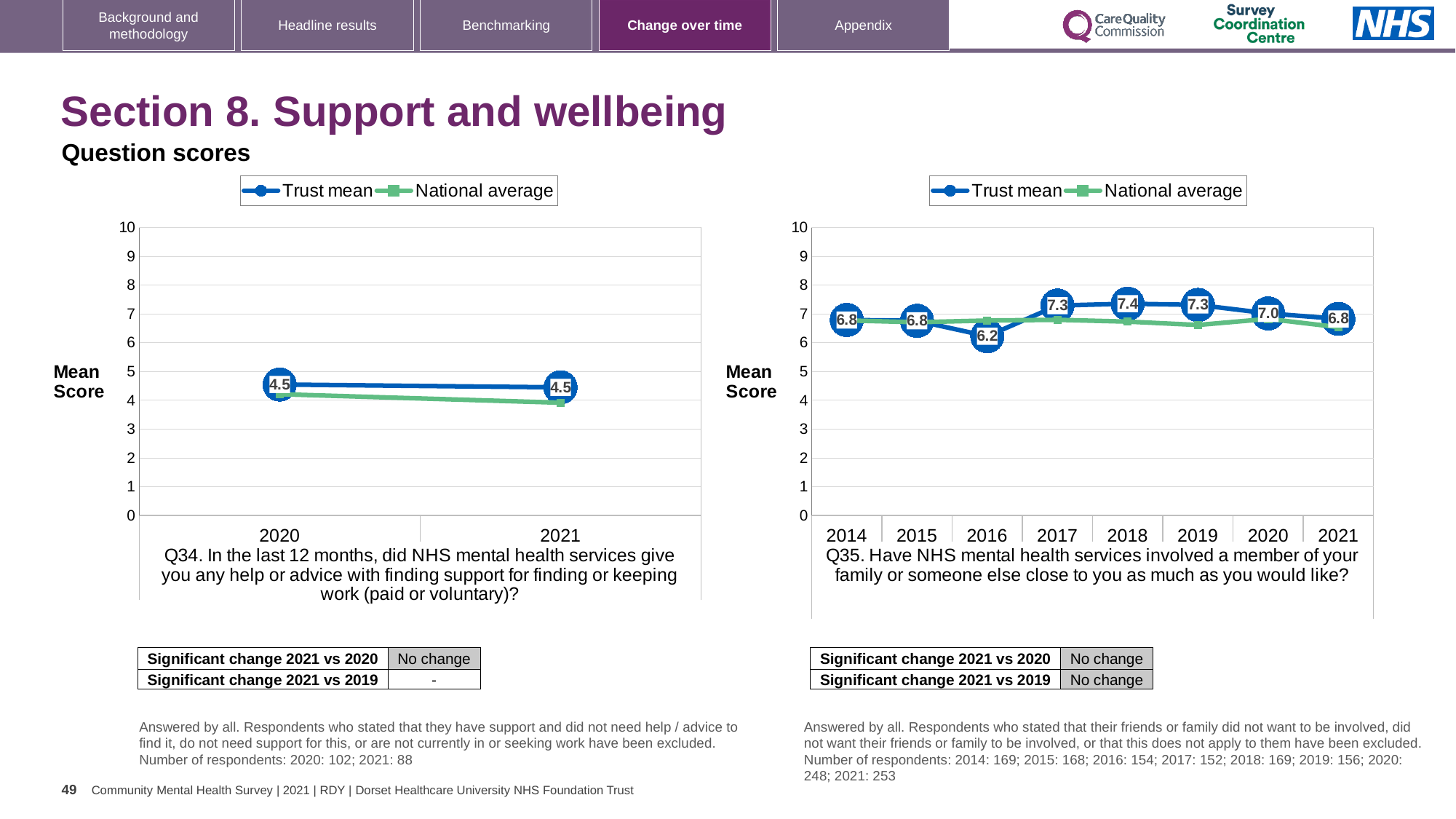
On the Q34 chart on the left, what is the Trust mean score for 2020? 4.5 On the Q35 chart on the right, what is the Trust mean score for 2016? 6.2 On the Q35 chart on the right, does the Trust mean score rise or fall from 2018 to 2021? fall On the Q34 chart on the left, what is the Trust mean score for 2021? 4.5 On the Q35 chart on the right, is the National average value for 2016 greater or less than 6? greater How many series does the legend of the Q34 chart on the left list? 2 On the Q35 chart on the right, what is the difference between the Trust mean scores for 2018 and 2016? 1.2 On the Q35 chart on the right, which year has the lowest Trust mean score? 2016 On the Q35 chart on the right, what is the Trust mean score for 2020? 7.0 How many years are shown on the x axis of the Q35 chart on the right? 8 On the Q35 chart on the right, is the Trust mean score for 2017 larger or smaller than the Trust mean score for 2021? larger On the Q35 chart on the right, which year has the highest Trust mean score? 2018